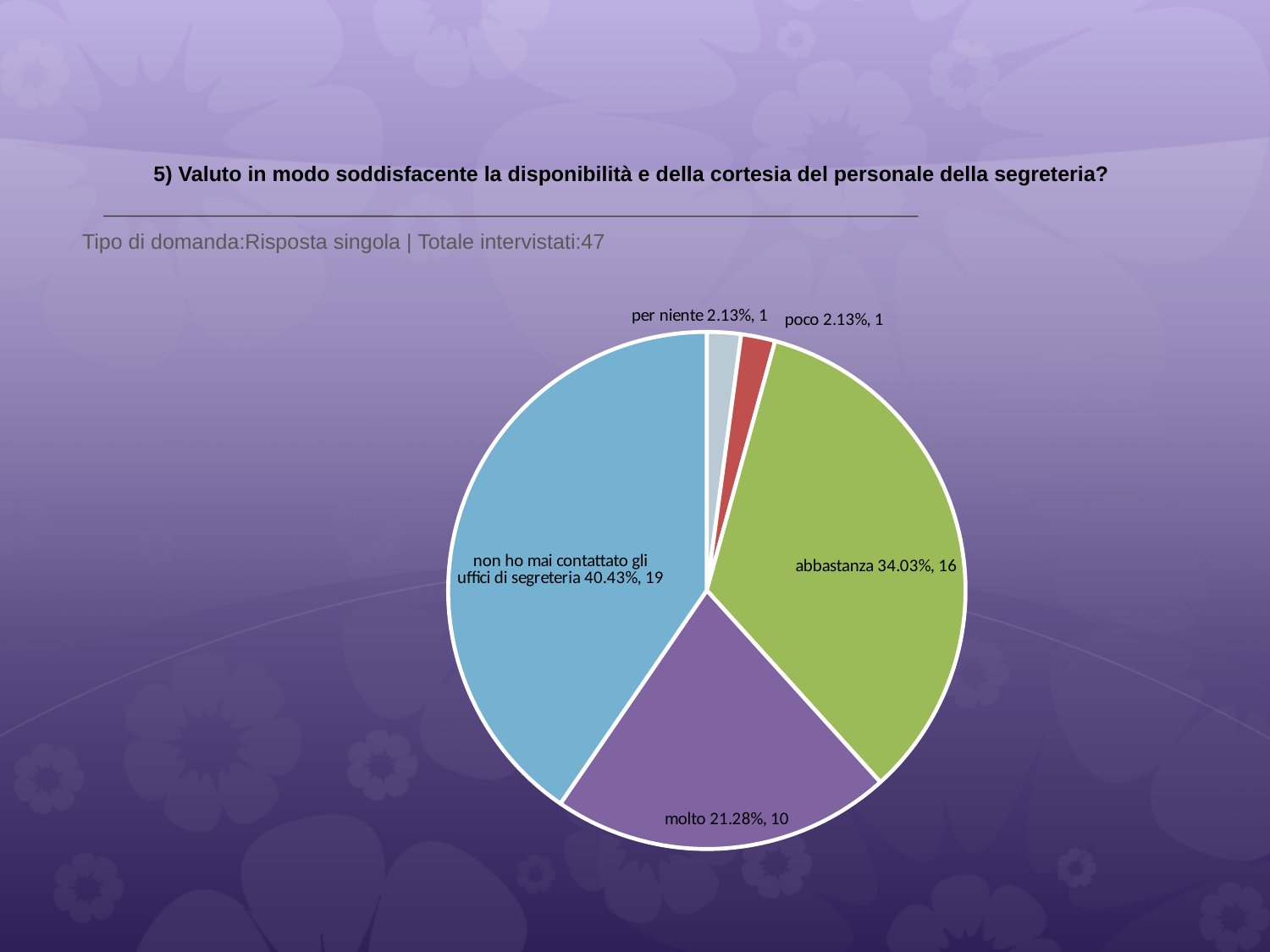
What kind of chart is shown on the slide? pie chart What is the total number of respondents (Totale intervistati) stated on the slide? 47 What share of the pie does "abbastanza" represent? 34.03% How many slices does the pie chart have? 5 How many respondents chose "molto"? 10 What share of the pie does "molto" represent? 21.28% Which has more respondents, "molto" or "abbastanza"? abbastanza How many respondents chose "abbastanza"? 16 What share of the pie does "poco" represent? 2.13% Which category has the largest slice of the pie? non ho mai contattato gli uffici di segreteria How many respondents chose "non ho mai contattato gli uffici di segreteria"? 19 What is the difference in respondents between "non ho mai contattato gli uffici di segreteria" and "abbastanza"? 3